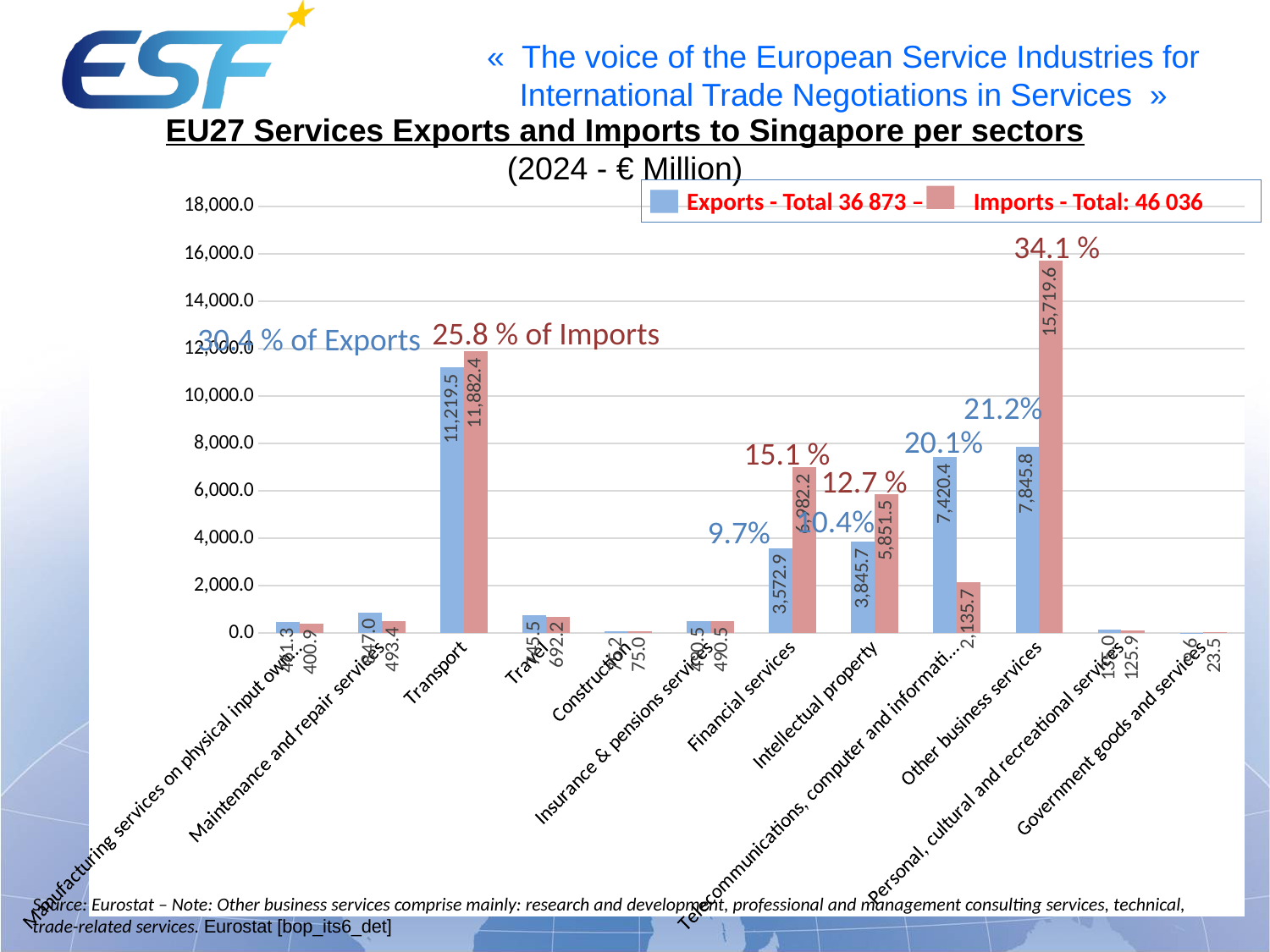
How many sectors are shown on the x axis? 12 How many series does the legend list? 2 What kind of chart is shown on the slide? bar chart What is the difference between Imports and Exports for Other business services? 7,873.8 What is the value of Imports for Intellectual property? 5,851.5 Is the Exports value for Financial services greater or less than 4,000.0? less What is the value of Exports for Telecommunications, computer and information services? 7,420.4 For Telecommunications, computer and information services, which is larger: Exports or Imports? Exports What is the value of Exports for Transport? 11,219.5 Which sector has the highest Exports value? Transport Which sector has the highest Imports value? Other business services What is the value of Imports for Other business services? 15,719.6